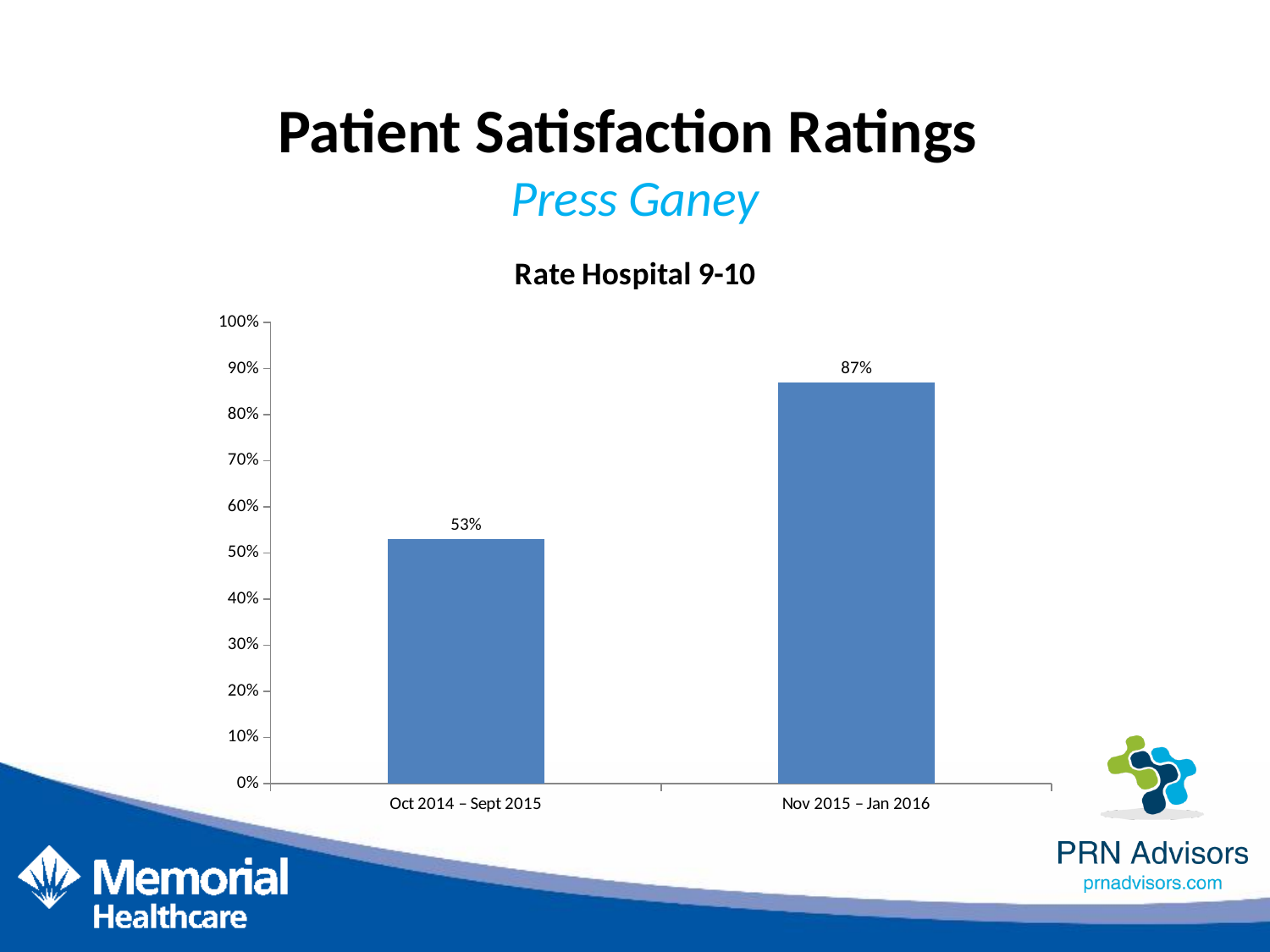
What is the title of the chart? Rate Hospital 9-10 What is the value for Nov 2015 – Jan 2016? 87% How many categories are shown on the chart? 2 Which period has the highest value? Nov 2015 – Jan 2016 Do the values rise or fall from Oct 2014 – Sept 2015 to Nov 2015 – Jan 2016? rise What kind of chart is shown on the slide? bar chart Is the value for Oct 2014 – Sept 2015 greater or less than 60%? less Which is larger, the value for Oct 2014 – Sept 2015 or the value for Nov 2015 – Jan 2016? Nov 2015 – Jan 2016 What is the value for Oct 2014 – Sept 2015? 53% What is the difference between the values for Nov 2015 – Jan 2016 and Oct 2014 – Sept 2015? 34% Is the value for Nov 2015 – Jan 2016 greater or less than 80%? greater Which period has the lowest value? Oct 2014 – Sept 2015